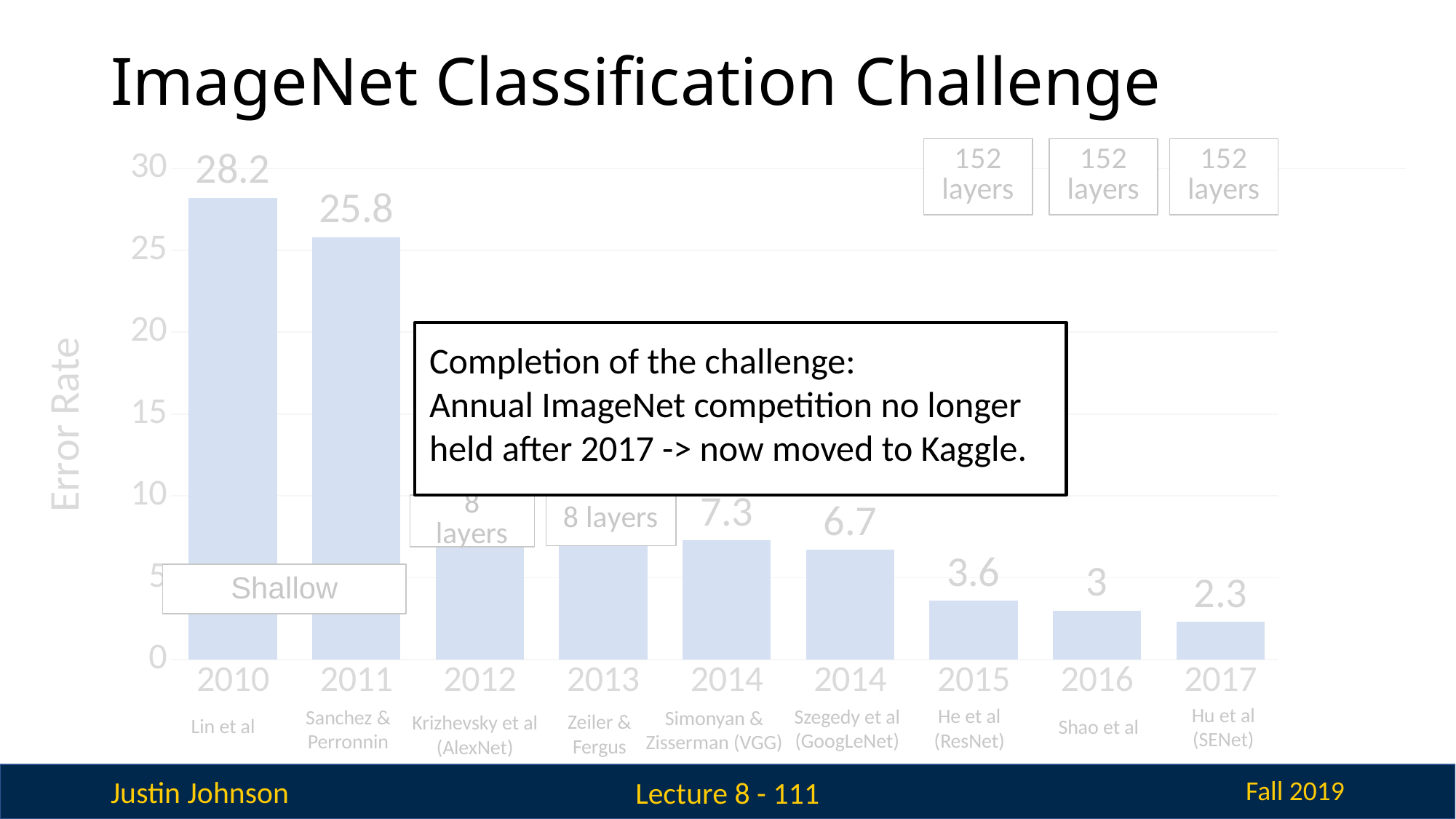
What is the difference in error rate between 2010 and 2011? 2.4 What is the error rate for 2017 (Hu et al, SENet)? 2.3 How many bars are plotted in the chart? 9 Which year has the lowest error rate? 2017 Which year has the highest error rate? 2010 What type of chart is shown on the slide? bar chart What is the error rate for 2011 (Sanchez & Perronnin)? 25.8 What is the error rate for the 2014 Szegedy et al (GoogLeNet) bar? 6.7 What is the label of the y-axis? Error Rate Which 2014 entry has the larger error rate, Simonyan & Zisserman (VGG) or Szegedy et al (GoogLeNet)? Simonyan & Zisserman (VGG) What is the error rate for 2010 (Lin et al)? 28.2 What is the error rate for 2015 (He et al, ResNet)? 3.6